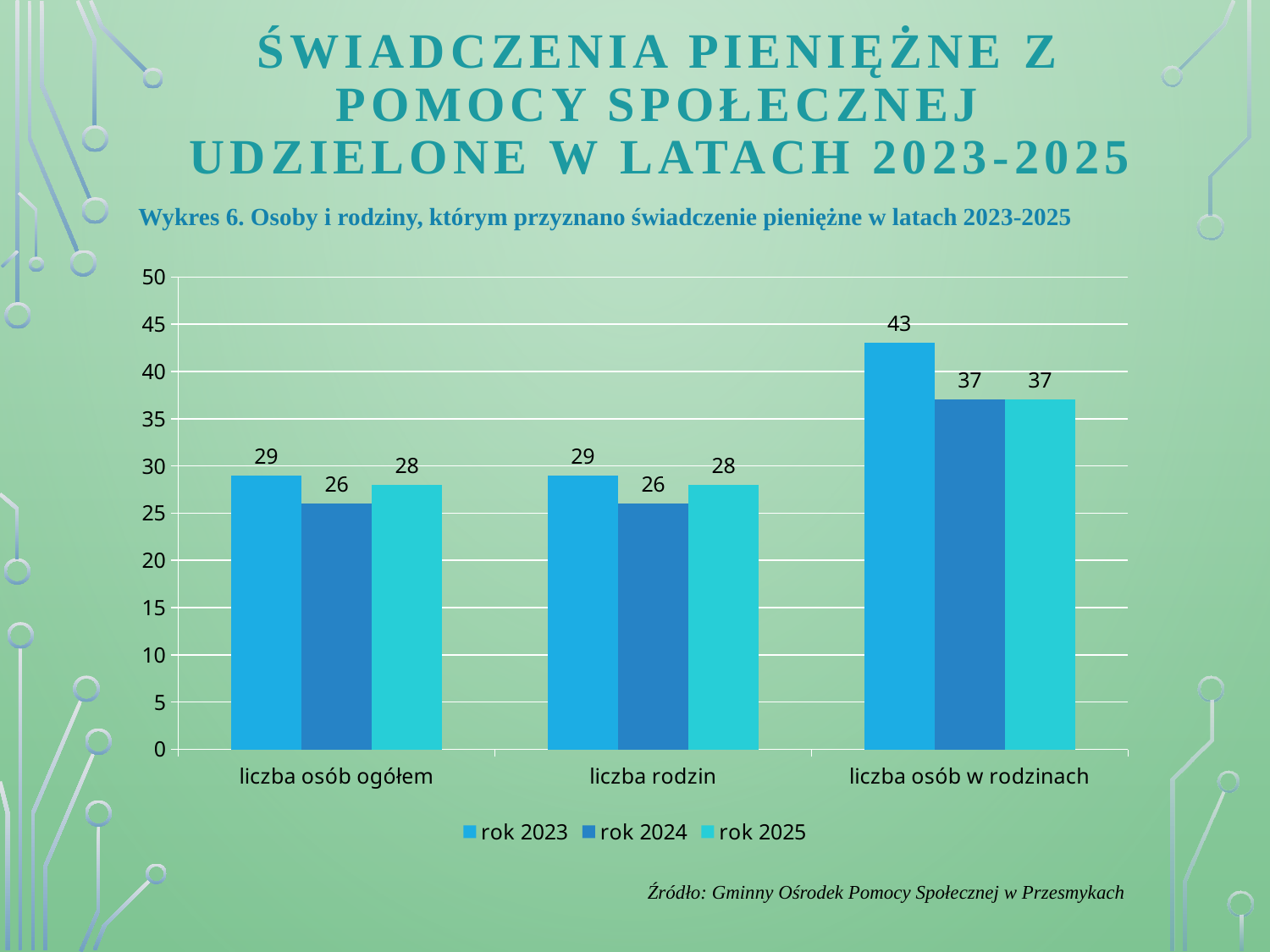
Which year has the lowest value for 'liczba osób ogółem'? rok 2024 How many series does the legend list? 3 What kind of chart is shown on the slide? bar chart What is the value for 'liczba rodzin' in the 'rok 2024' series? 26 What is the difference between the 'rok 2023' and 'rok 2024' values for 'liczba osób w rodzinach'? 6 Which category has the highest value in the 'rok 2023' series? liczba osób w rodzinach Is the 'rok 2023' value for 'liczba osób w rodzinach' greater or less than 40? greater What is the value for 'liczba osób w rodzinach' in the 'rok 2025' series? 37 How many categories are shown on the x axis? 3 Which is larger: the 'rok 2025' value for 'liczba rodzin' or the 'rok 2024' value for 'liczba rodzin'? rok 2025 What is the value for 'liczba osób ogółem' in the 'rok 2023' series? 29 What is the source given below the chart? Gminny Ośrodek Pomocy Społecznej w Przesmykach